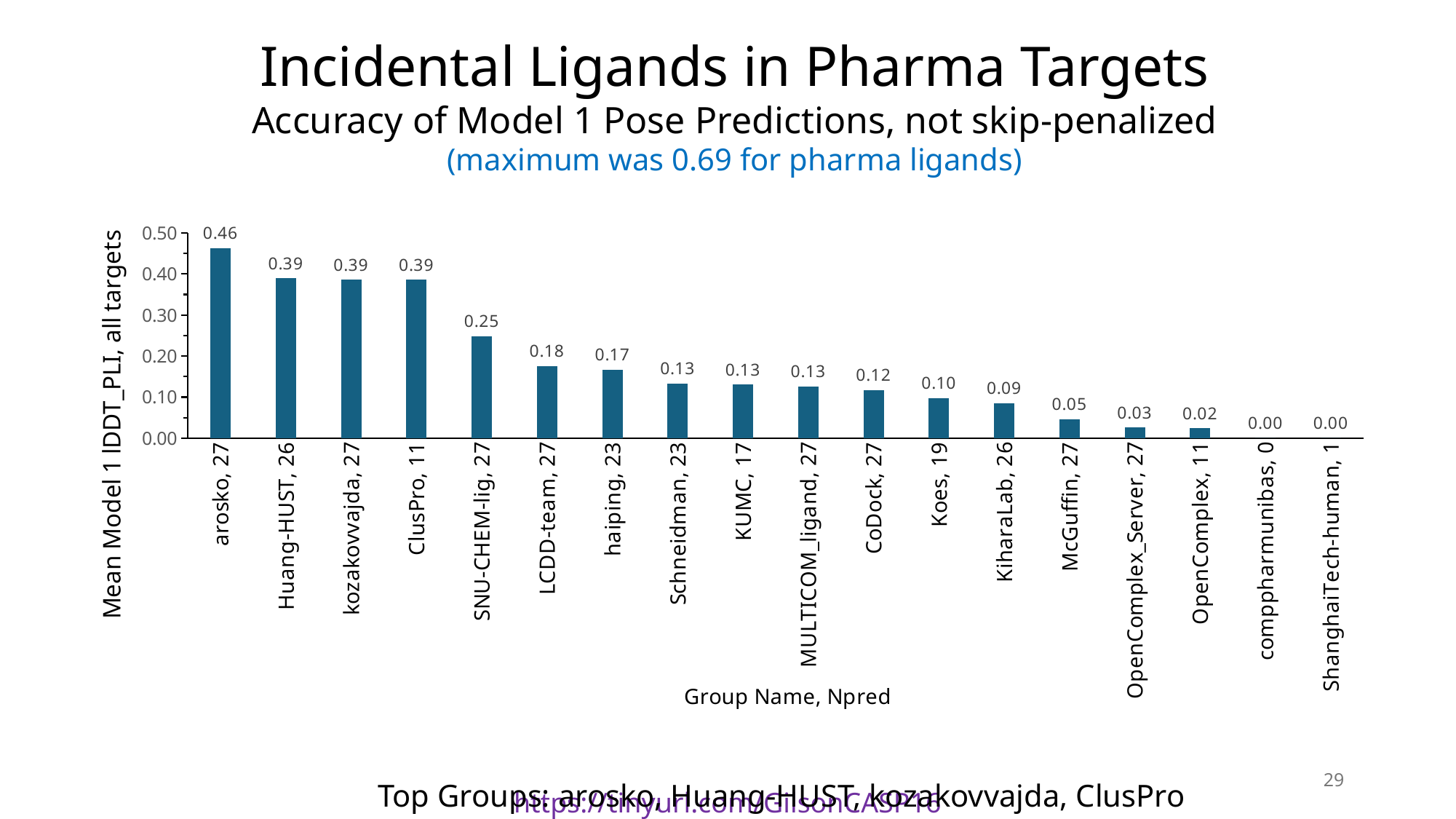
What is the difference between the values for arosko, 27 and SNU-CHEM-lig, 27? 0.21 Is the value for arosko, 27 greater or less than 0.40? greater What is the value for arosko, 27? 0.46 What kind of chart is shown on the slide? bar chart How many groups are shown on the x axis? 18 What is the value for Koes, 19? 0.10 Which is larger, the value for SNU-CHEM-lig, 27 or LCDD-team, 27? SNU-CHEM-lig, 27 What is the value for McGuffin, 27? 0.05 Do the values rise or fall from left to right along the x axis? fall Which group has the highest mean Model 1 lDDT_PLI? arosko, 27 What is the value for SNU-CHEM-lig, 27? 0.25 What is the label of the y axis? Mean Model 1 lDDT_PLI, all targets